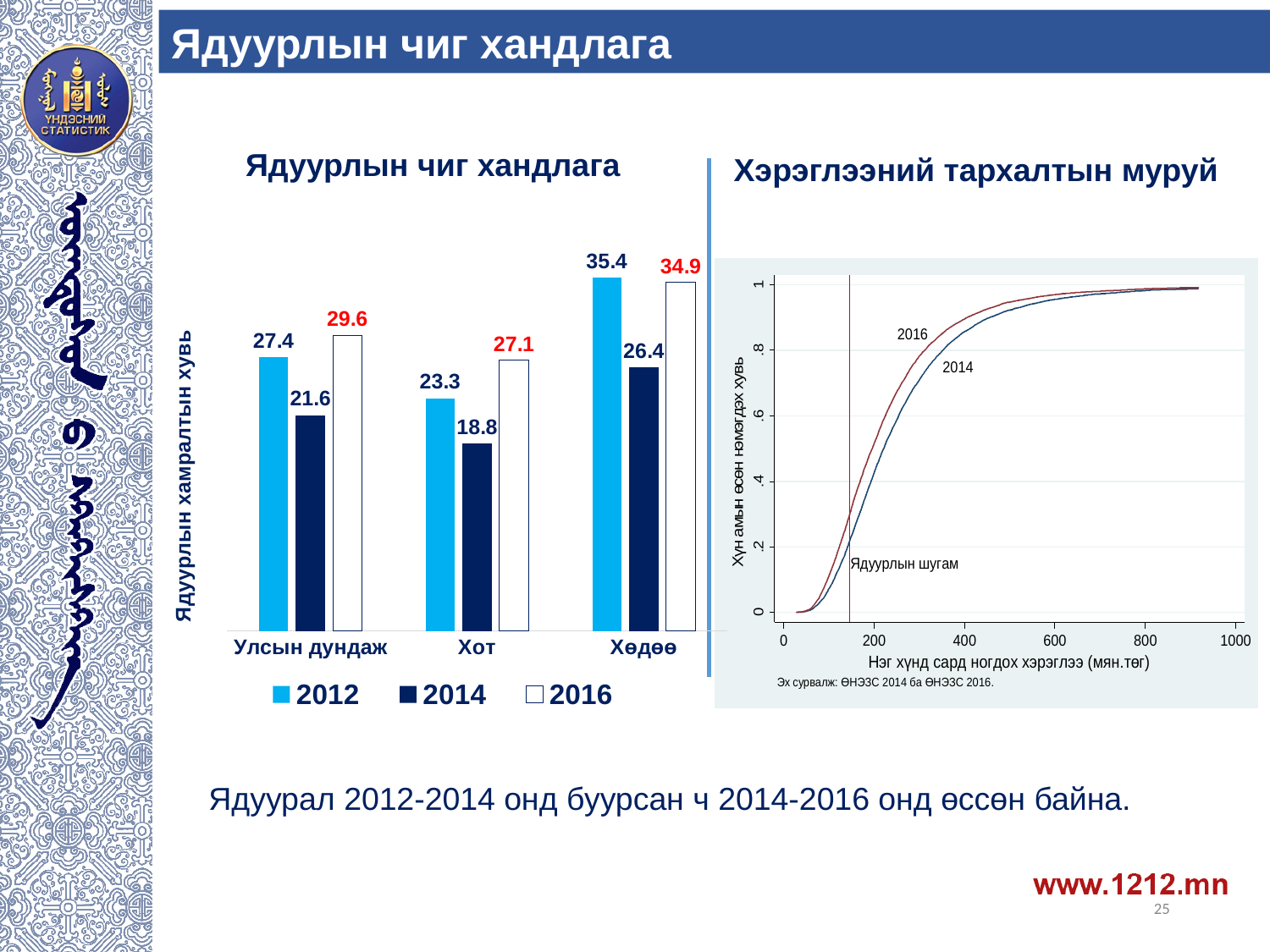
In the chart titled 'Ядуурлын чиг хандлага', what is the difference between the 2016 and 2014 values for Улсын дундаж? 8.0 In the chart titled 'Ядуурлын чиг хандлага', what is the value for Хот in 2016? 27.1 In the chart titled 'Ядуурлын чиг хандлага', which category has the lowest value for 2014? Хот In the chart titled 'Ядуурлын чиг хандлага', which category has the highest value for 2016? Хөдөө In the chart titled 'Ядуурлын чиг хандлага', how many series does the legend list? 3 In the chart titled 'Ядуурлын чиг хандлага', which is larger: the 2012 value for Хот or the 2016 value for Хот? 2016 value for Хот What kind of chart is the chart titled 'Ядуурлын чиг хандлага'? Bar chart In the chart titled 'Хэрэглээний тархалтын муруй', what is the highest tick value shown on the x axis? 1000 In the chart titled 'Ядуурлын чиг хандлага', how many categories are shown on the x axis? 3 In the chart titled 'Ядуурлын чиг хандлага', what is the value for Хөдөө in 2012? 35.4 In the chart titled 'Ядуурлын чиг хандлага', what is the difference between the 2012 and 2014 values for Хөдөө? 9.0 In the chart titled 'Ядуурлын чиг хандлага', what is the value for Улсын дундаж in 2014? 21.6